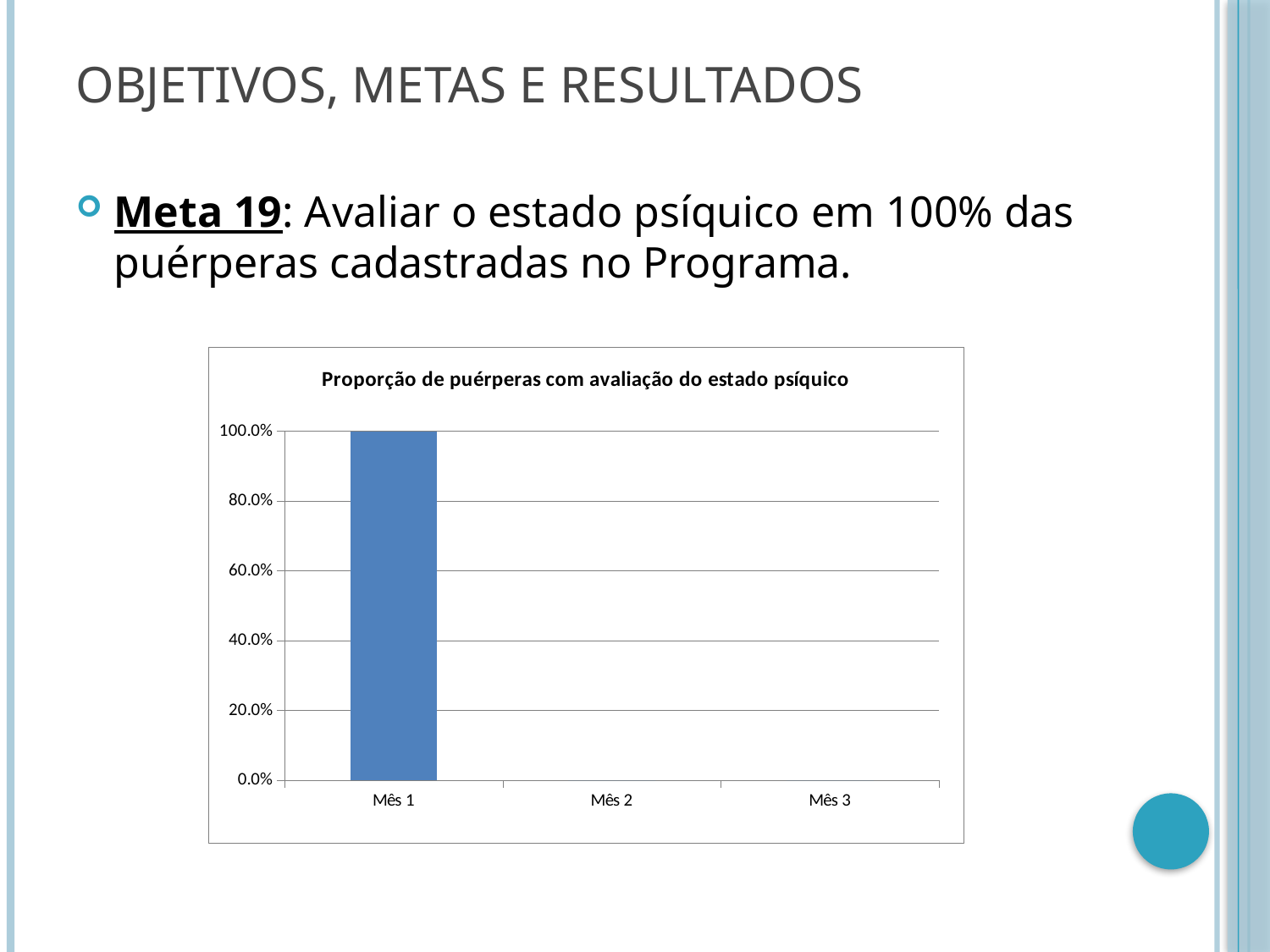
What kind of chart is shown on the slide? bar chart Which is larger, the value for Mês 1 or the value for Mês 2? Mês 1 What is the label of the first category on the x axis? Mês 1 Is the value for Mês 1 greater or less than 80.0%? greater How many categories are shown on the x axis of the chart? 3 What is the title of the chart? Proporção de puérperas com avaliação do estado psíquico Which category has the highest value in the chart? Mês 1 What is the value for Mês 1 in the chart? 100.0% What is the highest value shown on the y axis of the chart? 100.0% Which is larger, the value for Mês 1 or the value for Mês 3? Mês 1